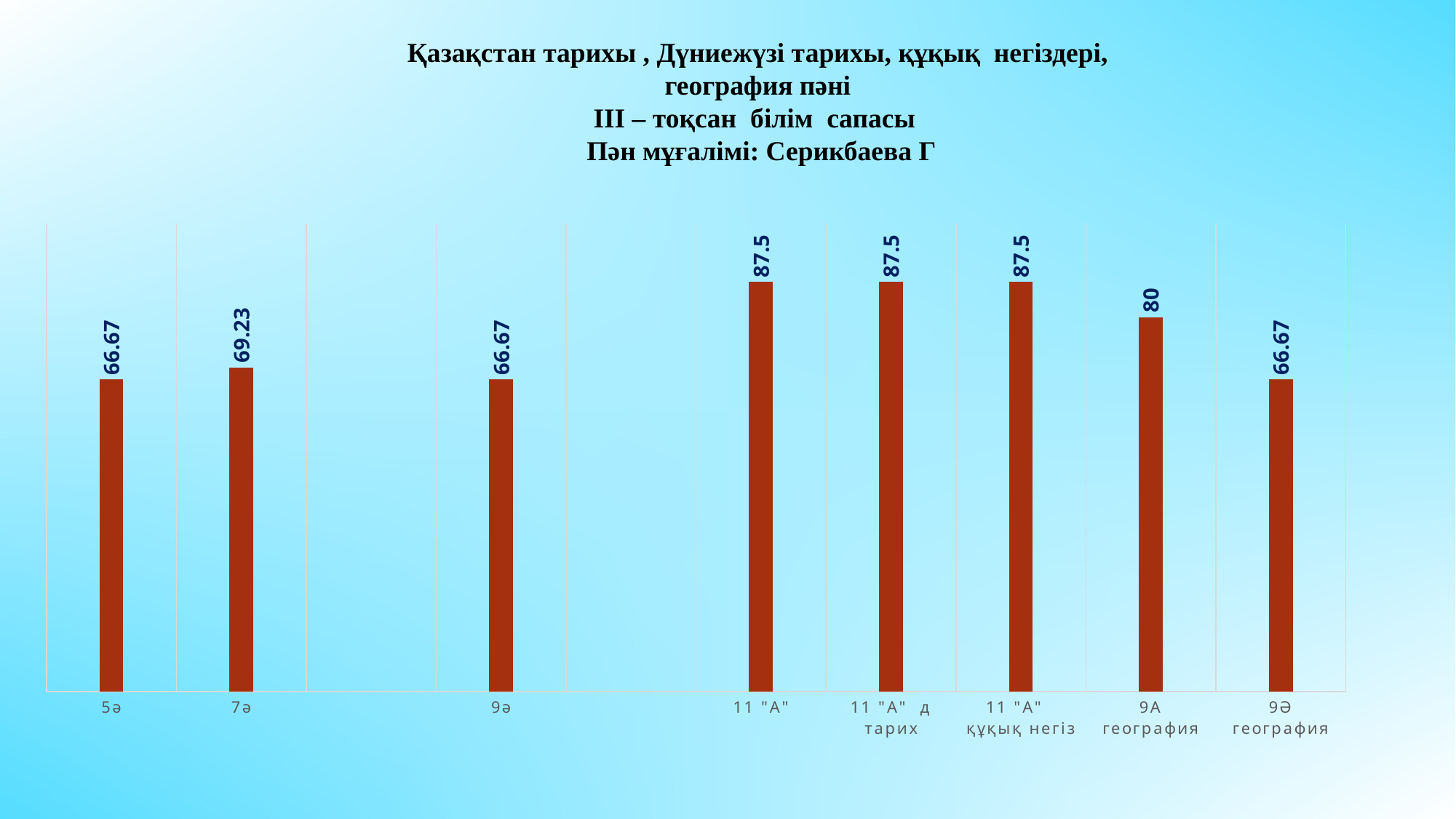
What is the value for 5ә? 66.67 Who is named as the subject teacher in the chart title? Серикбаева Г What is the value for 7ә? 69.23 What kind of chart is shown on the slide? bar chart What is the difference between the values for 11 "А" and 9А география? 7.5 How many bars are shown on the chart? 8 What is the value for 9А география? 80 What is the value for 11 "А" құқық негіз? 87.5 What is the lowest value shown on the chart? 66.67 What is the highest value shown on the chart? 87.5 What is the difference between the values for 7ә and 5ә? 2.56 Which is larger, the value for 9А география or the value for 9Ә география? 9А география